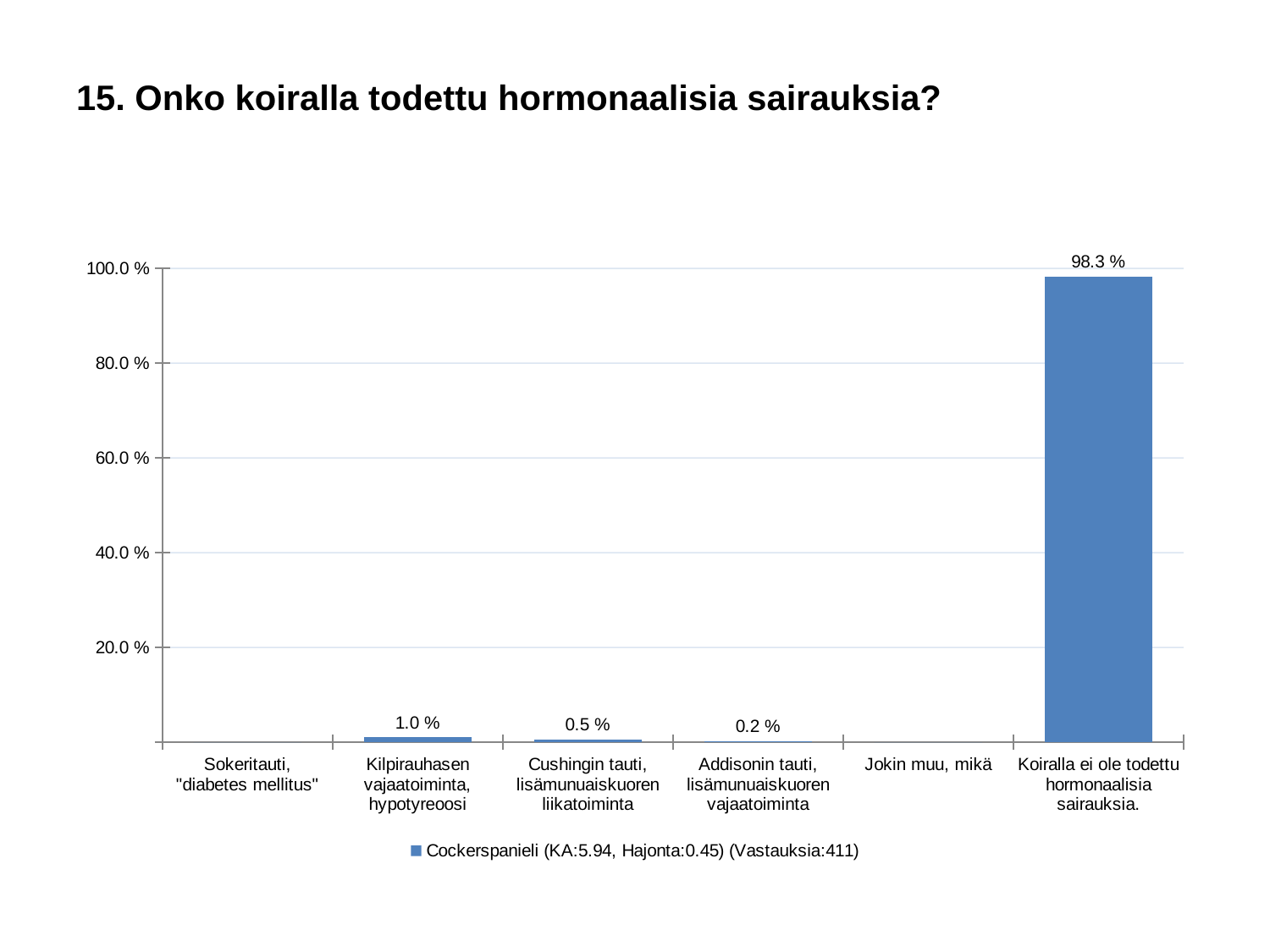
What kind of chart is shown on the slide? bar chart What is the value for "Cushingin tauti, lisämunuaiskuoren liikatoiminta"? 0.5 % What is the value for "Kilpirauhasen vajaatoiminta, hypotyreoosi"? 1.0 % What is the value for "Addisonin tauti, lisämunuaiskuoren vajaatoiminta"? 0.2 % What is the title of the slide? 15. Onko koiralla todettu hormonaalisia sairauksia? How many series does the legend list? 1 How many categories are shown on the x axis? 6 What is the difference between the values for "Kilpirauhasen vajaatoiminta, hypotyreoosi" and "Cushingin tauti, lisämunuaiskuoren liikatoiminta"? 0.5 % Which category has the highest value? Koiralla ei ole todettu hormonaalisia sairauksia. Is the value for "Koiralla ei ole todettu hormonaalisia sairauksia." greater or less than 80.0 %? greater Which is larger, the value for "Kilpirauhasen vajaatoiminta, hypotyreoosi" or the value for "Addisonin tauti, lisämunuaiskuoren vajaatoiminta"? Kilpirauhasen vajaatoiminta, hypotyreoosi What is the value for "Koiralla ei ole todettu hormonaalisia sairauksia."? 98.3 %